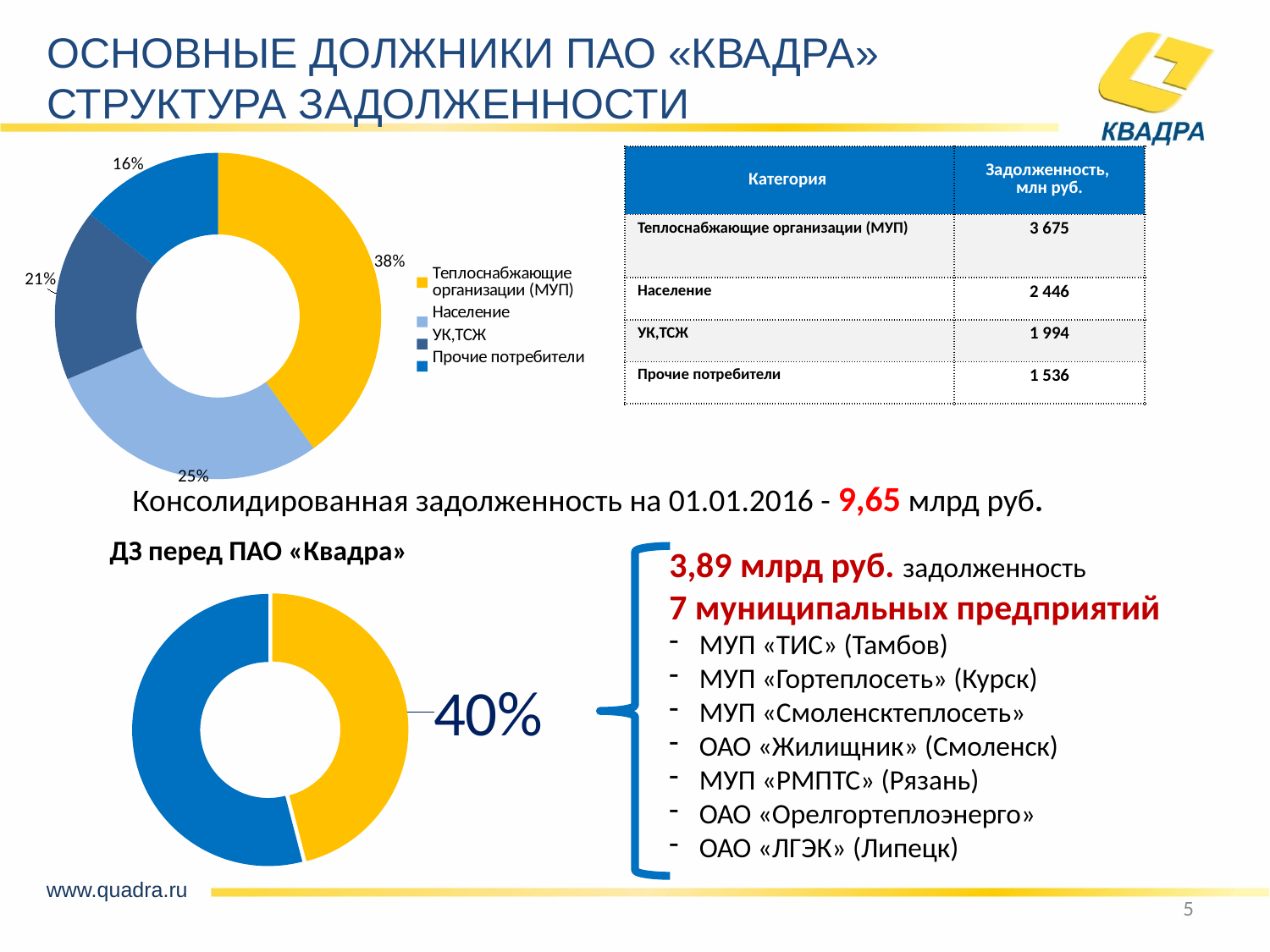
What type of chart is shown at the top left of the slide? Doughnut chart In the top-left doughnut chart, which is larger: the share for Население or the share for УК,ТСЖ? Население In the top-left doughnut chart, what is the difference in percentage points between Теплоснабжающие организации (МУП) and Прочие потребители? 22 In the top-left doughnut chart, what share is shown for УК,ТСЖ? 21% In the chart titled «ДЗ перед ПАО «Квадра»», what percentage is labelled on the chart? 40% In the top-left doughnut chart, what share is shown for Население? 25% What type of chart is the one titled «ДЗ перед ПАО «Квадра»»? Doughnut chart In the top-left doughnut chart, what share is shown for Теплоснабжающие организации (МУП)? 38% In the top-left doughnut chart, which category has the smallest share? Прочие потребители In the top-left doughnut chart, what share is shown for Прочие потребители? 16% How many categories does the legend of the top-left doughnut chart list? 4 In the top-left doughnut chart, which category has the largest share? Теплоснабжающие организации (МУП)